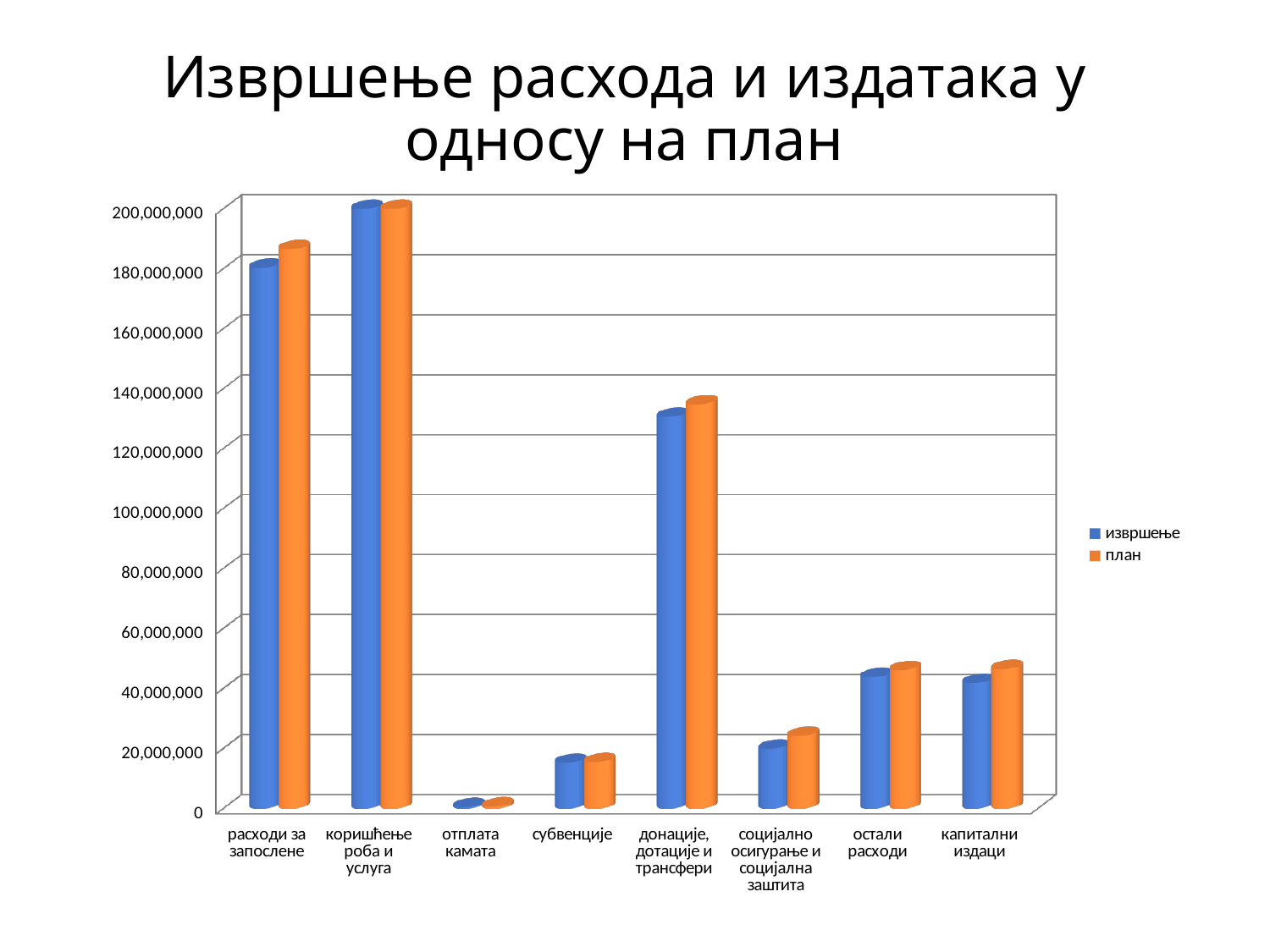
How many categories are shown on the x axis of the chart? 8 Which category has a larger извршење value: донације, дотације и трансфери or остали расходи? донације, дотације и трансфери Is the план value for капитални издаци greater or less than 60,000,000? less What kind of chart is shown on the slide? bar chart What is the title of the chart on the slide? Извршење расхода и издатака у односу на план Is the извршење value for расходи за запослене greater or less than 160,000,000? greater Which category has the lowest values in the chart? отплата камата How many series does the legend list? 2 Which category has the highest values in the chart? коришћење роба и услуга Is the извршење value for субвенције greater or less than 20,000,000? less For расходи за запослене, which is larger: извршење or план? план